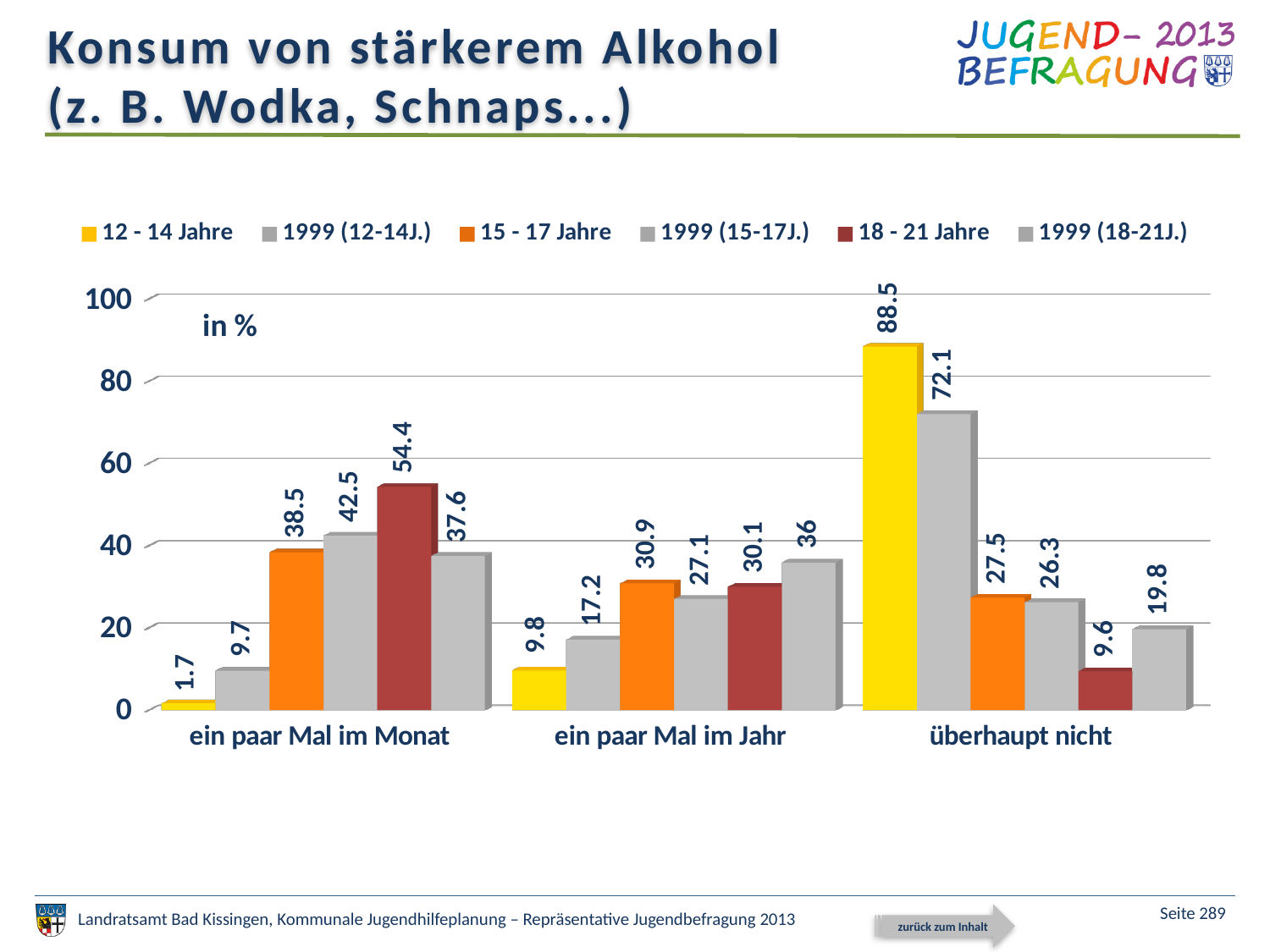
How many categories are shown on the x axis? 3 In the category "ein paar Mal im Monat", which is larger: "15 - 17 Jahre" or "1999 (15-17J.)"? 1999 (15-17J.) Which series has the lowest value in the category "ein paar Mal im Monat"? 12 - 14 Jahre What is the value for "1999 (18-21J.)" in the category "überhaupt nicht"? 19.8 Is the value for "18 - 21 Jahre" in the category "überhaupt nicht" greater or less than 20? less What is the difference between the "12 - 14 Jahre" and "1999 (12-14J.)" values in the category "überhaupt nicht"? 16.4 Which series has the highest value in the category "ein paar Mal im Jahr"? 1999 (18-21J.) What is the value for "18 - 21 Jahre" in the category "ein paar Mal im Monat"? 54.4 How many series does the legend list? 6 What kind of chart is shown on the slide? bar chart What is the value for "1999 (15-17J.)" in the category "ein paar Mal im Jahr"? 27.1 What is the value for "12 - 14 Jahre" in the category "überhaupt nicht"? 88.5